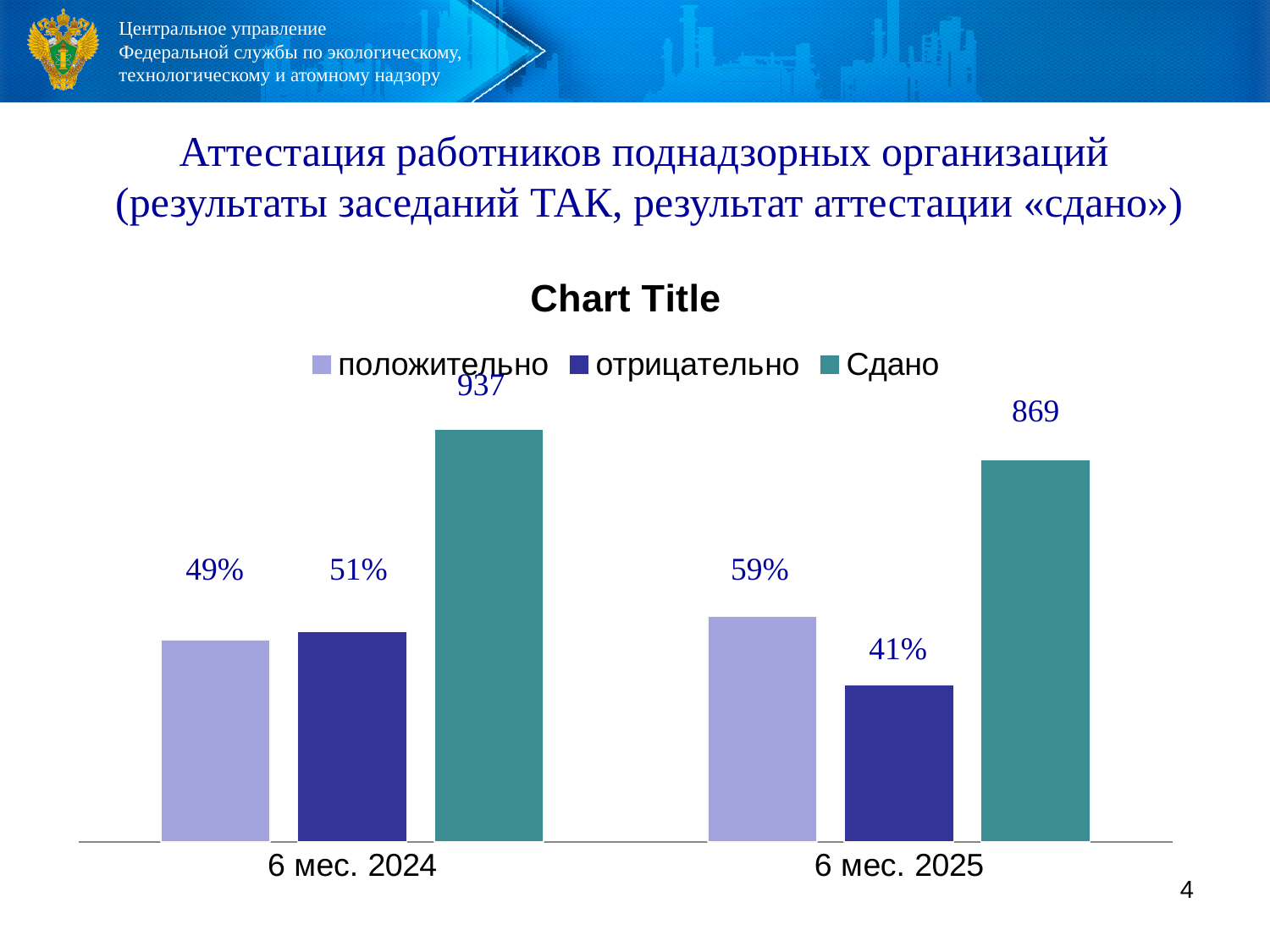
What is the value for "положительно" in 6 мес. 2025? 59% What is the difference between the "Сдано" values for 6 мес. 2024 and 6 мес. 2025? 68 What is the value for "положительно" in 6 мес. 2024? 49% What is the value for "отрицательно" in 6 мес. 2024? 51% What is the value for "Сдано" in 6 мес. 2025? 869 What is the value for "Сдано" in 6 мес. 2024? 937 What is the value for "отрицательно" in 6 мес. 2025? 41% Which period has the higher "Сдано" value, 6 мес. 2024 or 6 мес. 2025? 6 мес. 2024 What kind of chart is shown on the slide? Bar chart How many categories are shown on the x axis? 2 In 6 мес. 2025, which is larger, "положительно" or "отрицательно"? положительно How many series does the legend list? 3